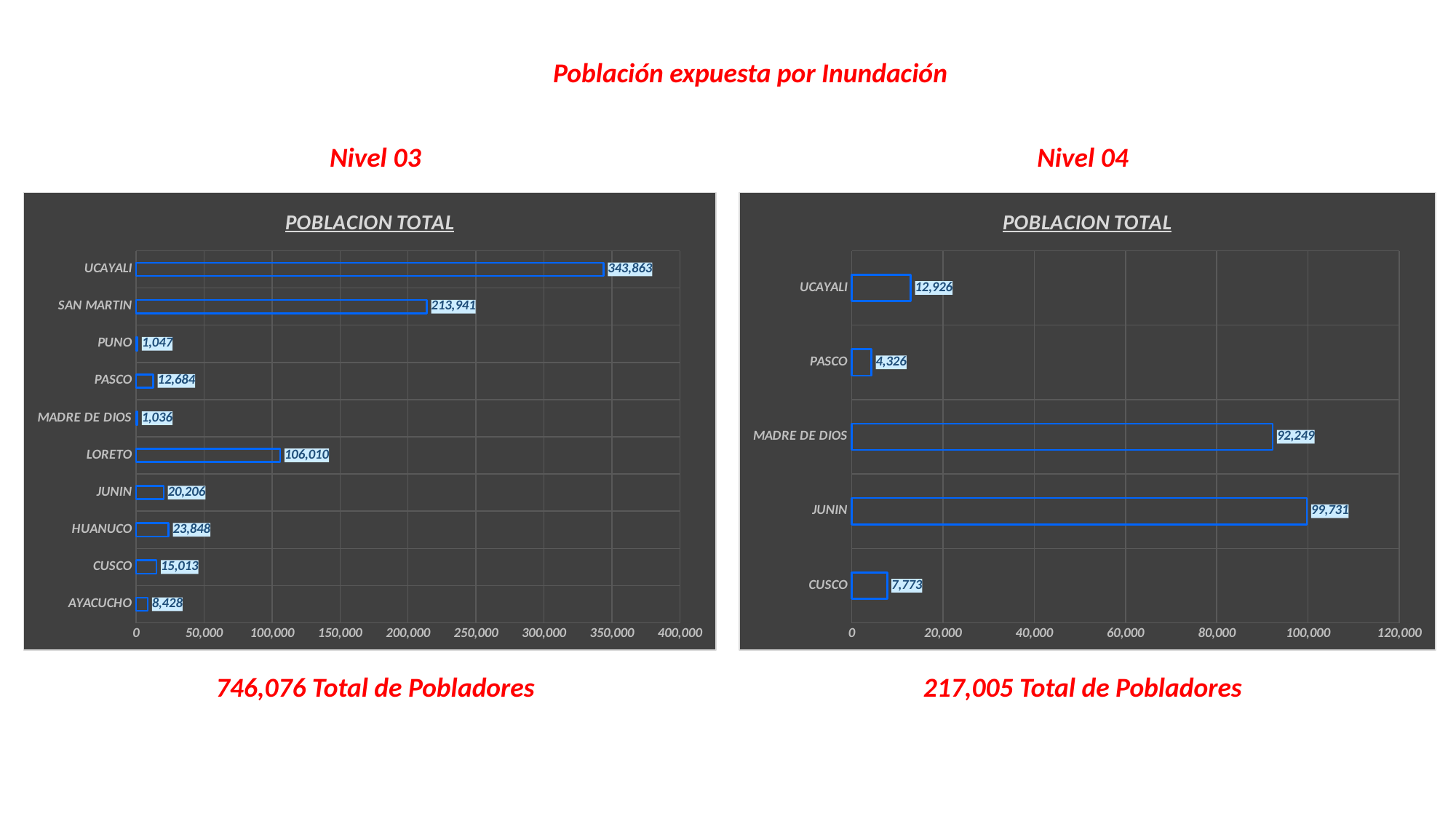
In the Nivel 03 chart, what is the value for UCAYALI? 343,863 In the Nivel 04 chart, what is the difference between JUNIN and MADRE DE DIOS? 7,482 How many categories are shown in the Nivel 03 chart? 10 In the Nivel 04 chart, what is the value for MADRE DE DIOS? 92,249 What kind of chart is the Nivel 04 chart? Bar chart In the Nivel 04 chart, what is the value for CUSCO? 7,773 In the Nivel 03 chart, what is the value for LORETO? 106,010 In the Nivel 04 chart, which category has the lowest value? PASCO In the Nivel 03 chart, which category has the highest value? UCAYALI In the Nivel 03 chart, what is the difference between UCAYALI and SAN MARTIN? 129,922 How many categories are shown in the Nivel 04 chart? 5 In the Nivel 03 chart, which is larger, HUANUCO or JUNIN? HUANUCO